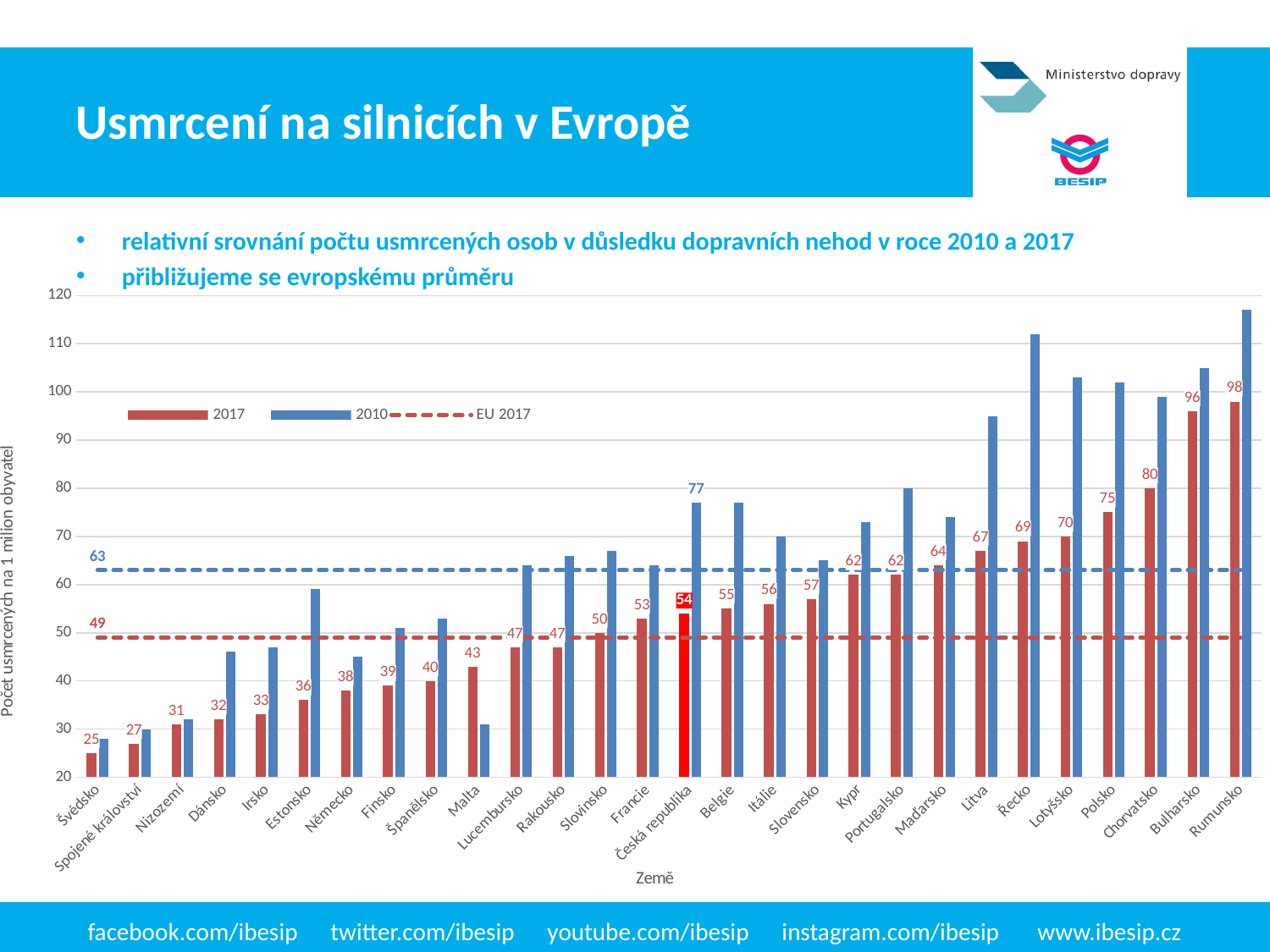
How many countries are shown on the x axis? 28 By how much did the value for Česká republika fall from 2010 to 2017? 23 Is the 2010 value for Rumunsko greater or less than 110? greater What is the 2017 value for Bulharsko? 96 Which country has the lowest 2017 value? Švédsko What value does the red dashed EU 2017 line mark? 49 What is the difference between the 2017 values for Rumunsko and Švédsko? 73 Which country has the highest 2017 value? Rumunsko What is the 2017 value for Česká republika? 54 Which has the larger 2017 value, Polsko or Lotyšsko? Polsko How many entries does the legend list? 3 What is the 2010 value for Česká republika? 77